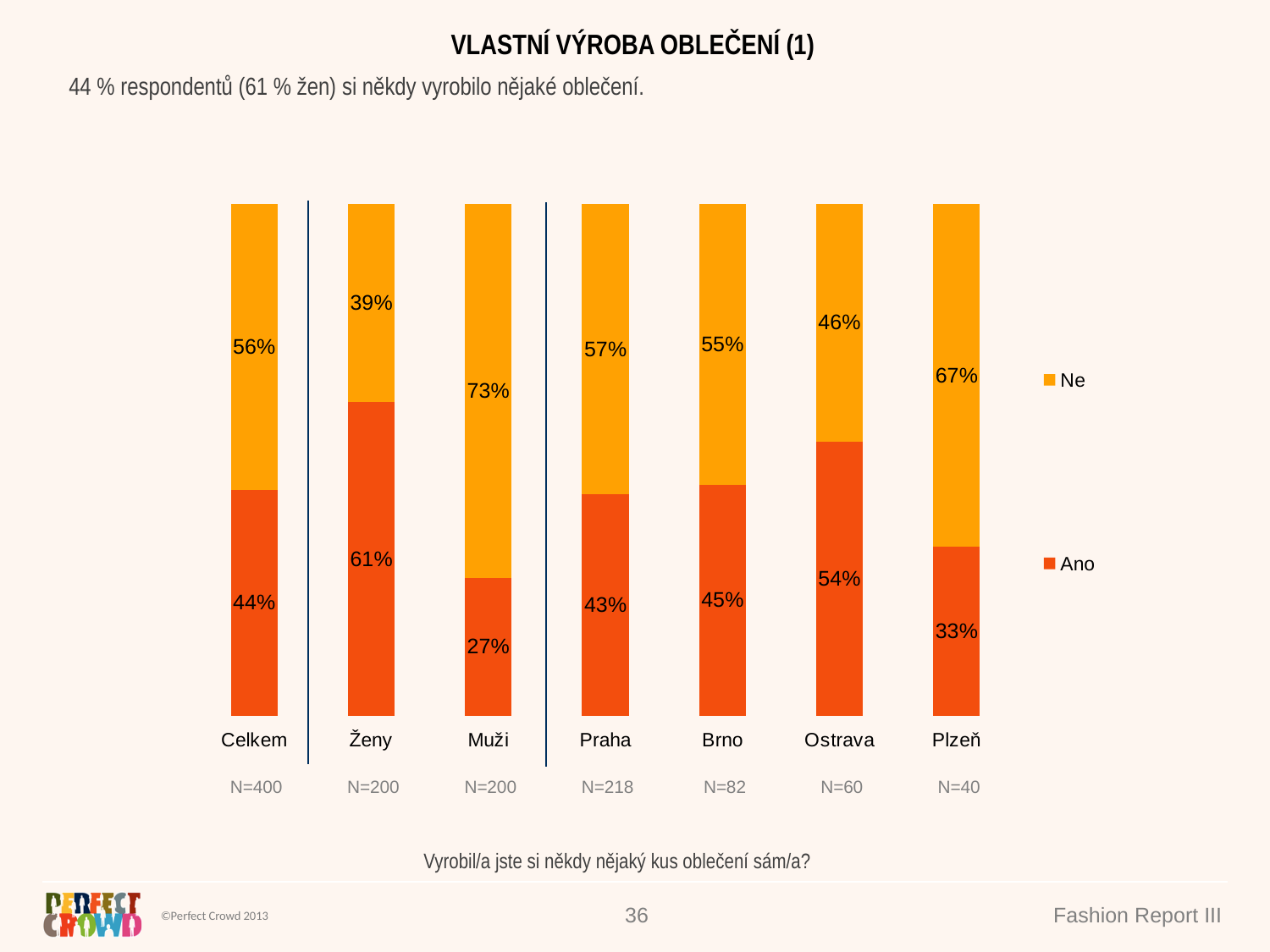
What is the total of the stacked bar for Praha? 100% Which category has the lowest "Ano" value? Muži Which has a larger "Ne" value, Plzeň or Brno? Plzeň What is the sample size (N) shown for Ostrava? N=60 How many series does the legend list? 2 What kind of chart is shown on the slide? Stacked bar chart What is the "Ano" value for Ostrava? 54% What is the difference between the "Ano" values for Ženy and Muži? 34% What is the "Ano" value for Celkem? 44% How many categories are shown on the x axis? 7 Which category has the highest "Ano" value? Ženy What is the "Ne" value for Muži? 73%